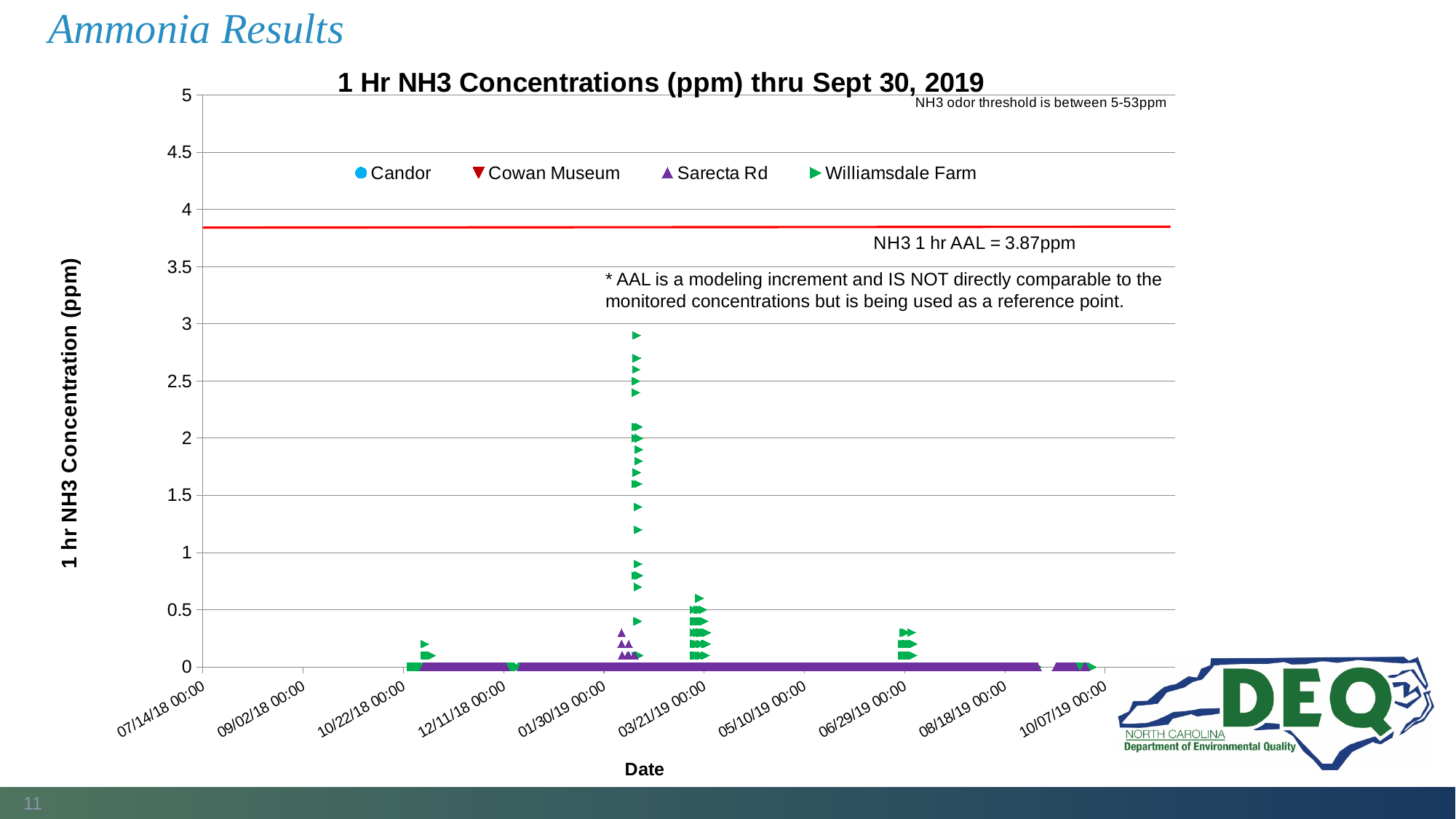
What is the title of the chart? 1 Hr NH3 Concentrations (ppm) thru Sept 30, 2019 Is the highest plotted Sarecta Rd value greater or less than 0.5? less What value does the red horizontal line represent, according to the label on the chart? NH3 1 hr AAL = 3.87ppm Is the highest plotted Williamsdale Farm value greater or less than 2.5? greater According to the note on the chart, what range is the NH3 odor threshold? between 5-53ppm Which series has the highest plotted concentration on the chart? Williamsdale Farm How many date tick labels are shown on the x axis? 10 Do any plotted points exceed the NH3 1 hr AAL line? No Which series is plotted with green triangles? Williamsdale Farm What kind of chart is shown on the slide? scatter chart How many series does the legend list? 4 Is the highest plotted Williamsdale Farm value greater or less than 3? less